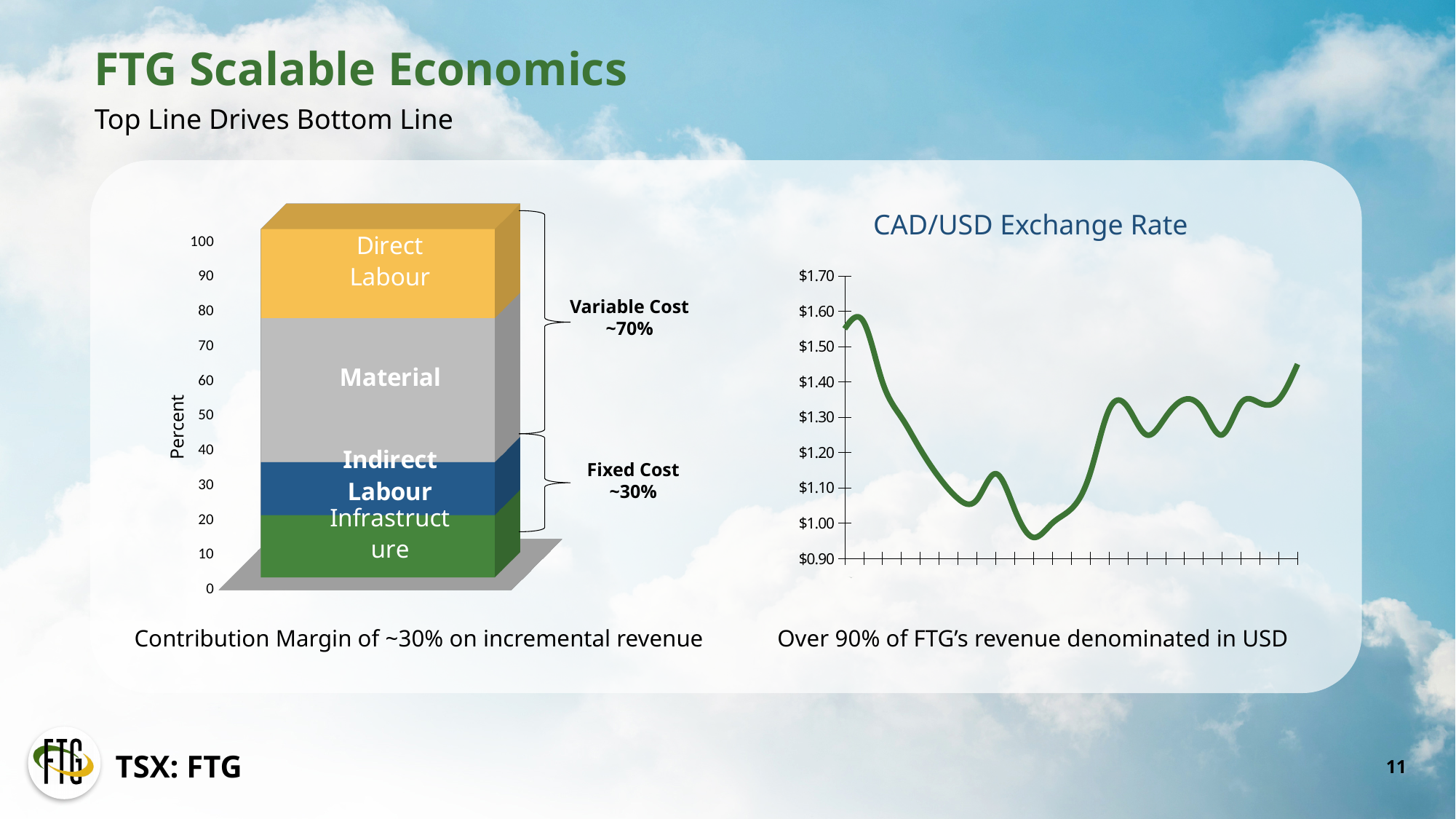
In the left chart, which segment is at the bottom of the stacked bar? Infrastructure What type of chart is the CAD/USD Exchange Rate chart? Line chart In the left chart, which segment is the largest? Material What is the title of the chart on the right of the slide? CAD/USD Exchange Rate In the CAD/USD Exchange Rate chart, is the value at the right end of the line greater or less than $1.40? greater What type of chart is the chart on the left of the slide? Bar chart In the CAD/USD Exchange Rate chart, is the line higher at its left end or at its right end? Left end How many segments make up the stacked bar in the left chart? 4 In the left chart, which segment is at the top of the stacked bar? Direct Labour In the left chart, is the Material segment larger or smaller than the Indirect Labour segment? Larger In the CAD/USD Exchange Rate chart, is the highest point of the line greater or less than $1.50? greater In the CAD/USD Exchange Rate chart, is the lowest point of the line greater or less than $1.00? less